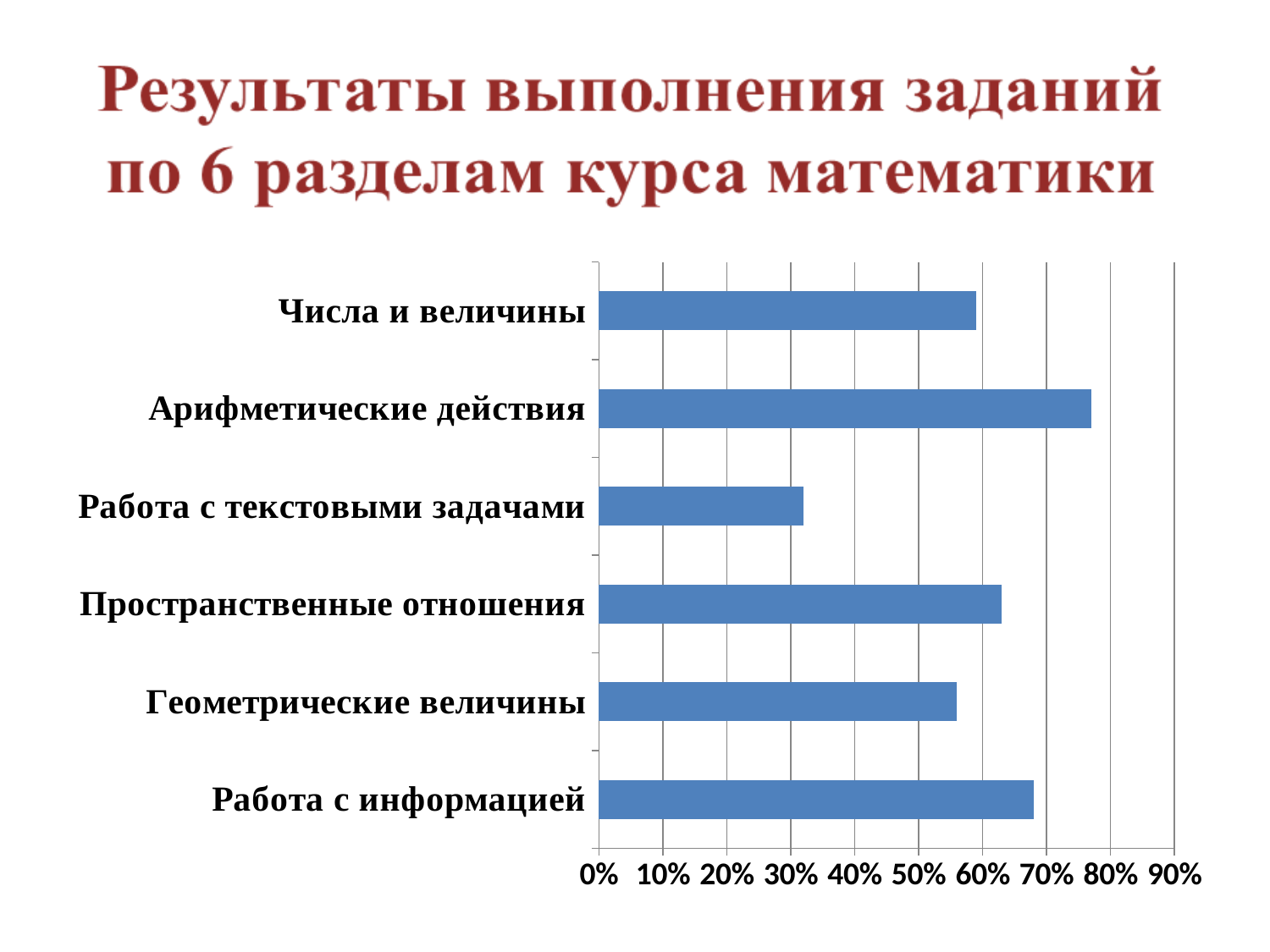
How many categories are plotted in the chart? 6 Which category has the highest value? Арифметические действия Which is larger, the value for Работа с информацией or the value for Геометрические величины? Работа с информацией What kind of chart is shown on the slide? bar chart Is the value for Числа и величины greater or less than 50%? greater Is the value for Работа с текстовыми задачами greater or less than 40%? less Which is larger, the value for Пространственные отношения or the value for Работа с текстовыми задачами? Пространственные отношения Is the value for Геометрические величины greater or less than 60%? less Which category has the lowest value? Работа с текстовыми задачами What is the title of the slide? Результаты выполнения заданий по 6 разделам курса математики